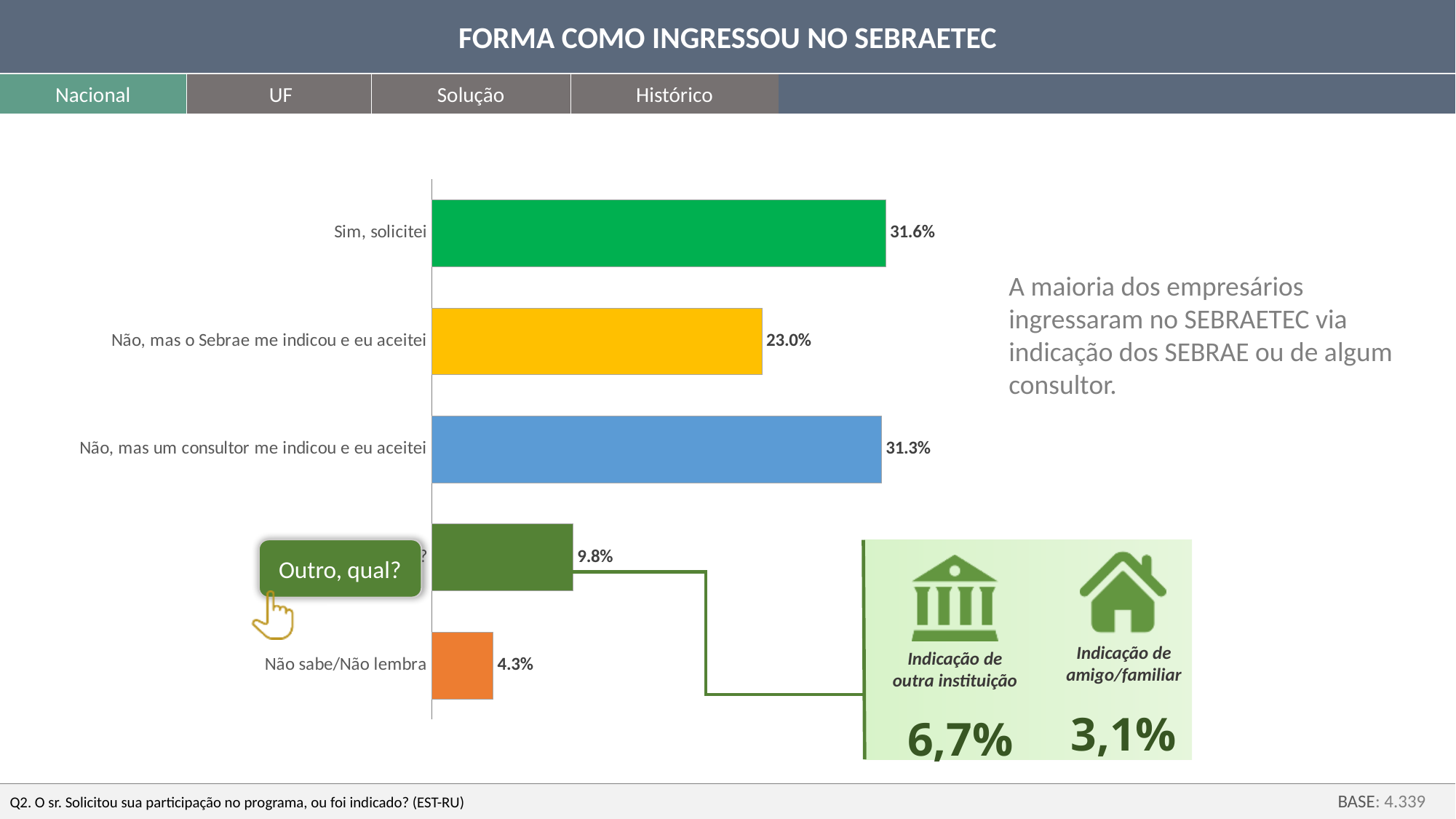
How many categories are shown in the bar chart? 5 What is the value for "Não sabe/Não lembra"? 4.3% What is the value for "Sim, solicitei"? 31.6% What is the value for "Não, mas um consultor me indicou e eu aceitei"? 31.3% Which is larger: "Não, mas o Sebrae me indicou e eu aceitei" or "Não sabe/Não lembra"? Não, mas o Sebrae me indicou e eu aceitei What kind of chart is shown on the slide? bar chart What is the difference between "Sim, solicitei" and "Não, mas o Sebrae me indicou e eu aceitei"? 8.6% What is the value for "Não, mas o Sebrae me indicou e eu aceitei"? 23.0% Which category has the highest value? Sim, solicitei What is the value for "Outro, qual?"? 9.8% What is the title of the slide containing the chart? FORMA COMO INGRESSOU NO SEBRAETEC Which category has the lowest value? Não sabe/Não lembra